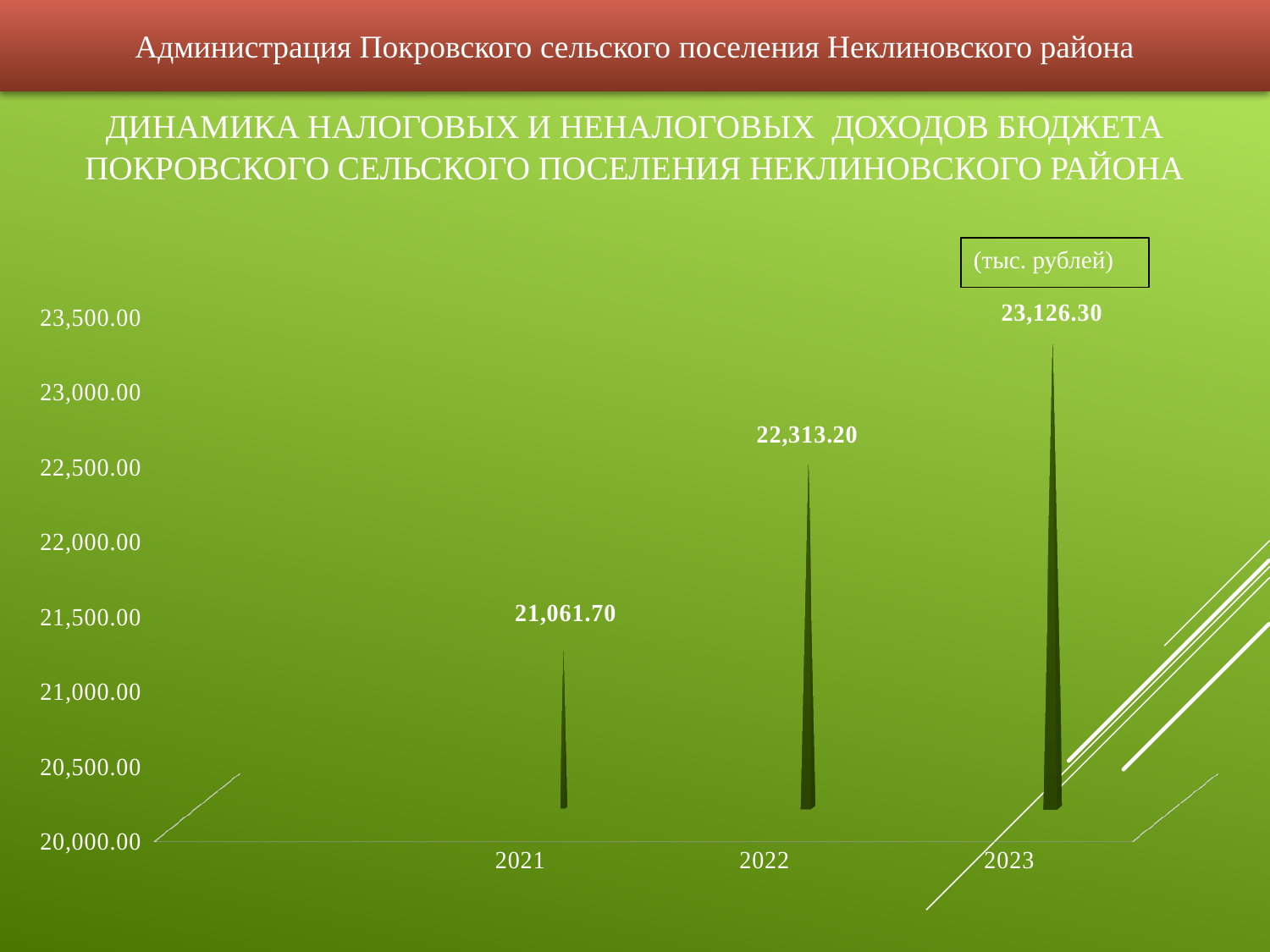
Is the value for 2023 greater or less than 23,000.00? greater How many years are shown on the x axis? 3 What is the value for 2023? 23,126.30 Which year has the lowest value? 2021 Which is larger, the value for 2021 or the value for 2022? 2022 Do the values rise or fall from 2021 to 2023? rise What is the value for 2021? 21,061.70 What is the difference between the values for 2022 and 2021? 1,251.50 What is the value for 2022? 22,313.20 What is the difference between the values for 2023 and 2022? 813.10 Which year has the highest value? 2023 What unit is shown in the box above the chart? тыс. рублей